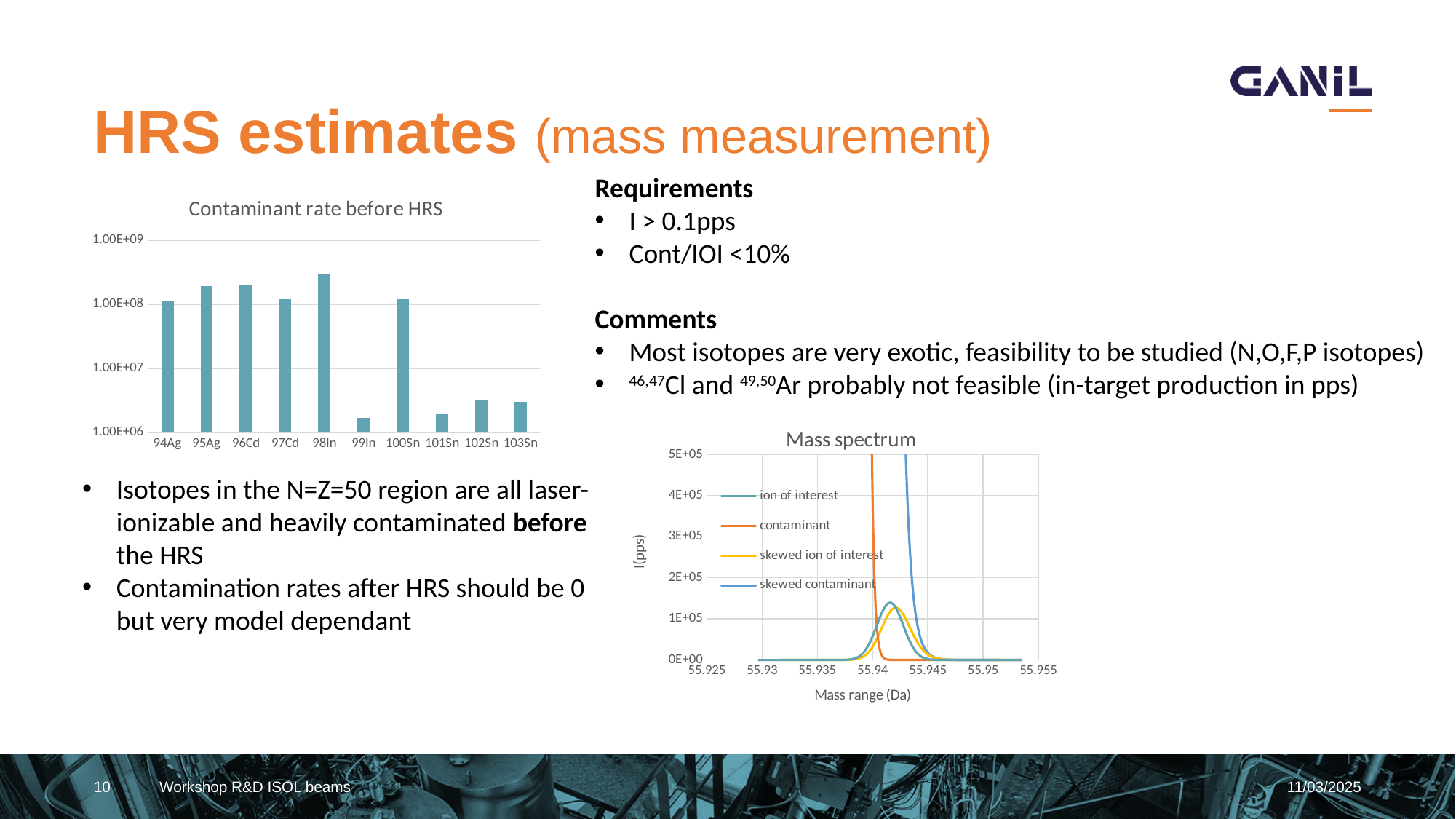
What type of chart is the 'Mass spectrum' chart? line chart What type of chart is the 'Contaminant rate before HRS' chart? bar chart How many isotopes are shown on the x axis of the 'Contaminant rate before HRS' chart? 10 How many series does the legend of the 'Mass spectrum' chart list? 4 In the 'Contaminant rate before HRS' chart, is the value for 102Sn greater or less than 1.00E+07? less What is the x-axis title of the 'Mass spectrum' chart? Mass range (Da) In the 'Contaminant rate before HRS' chart, is the value for 98In greater or less than 1.00E+08? greater In the 'Contaminant rate before HRS' chart, is the value for 99In greater or less than 1.00E+07? less In the 'Contaminant rate before HRS' chart, which has the larger contaminant rate, 98In or 99In? 98In In the 'Contaminant rate before HRS' chart, which has the larger contaminant rate, 100Sn or 101Sn? 100Sn In the 'Contaminant rate before HRS' chart, which isotope has the highest contaminant rate? 98In